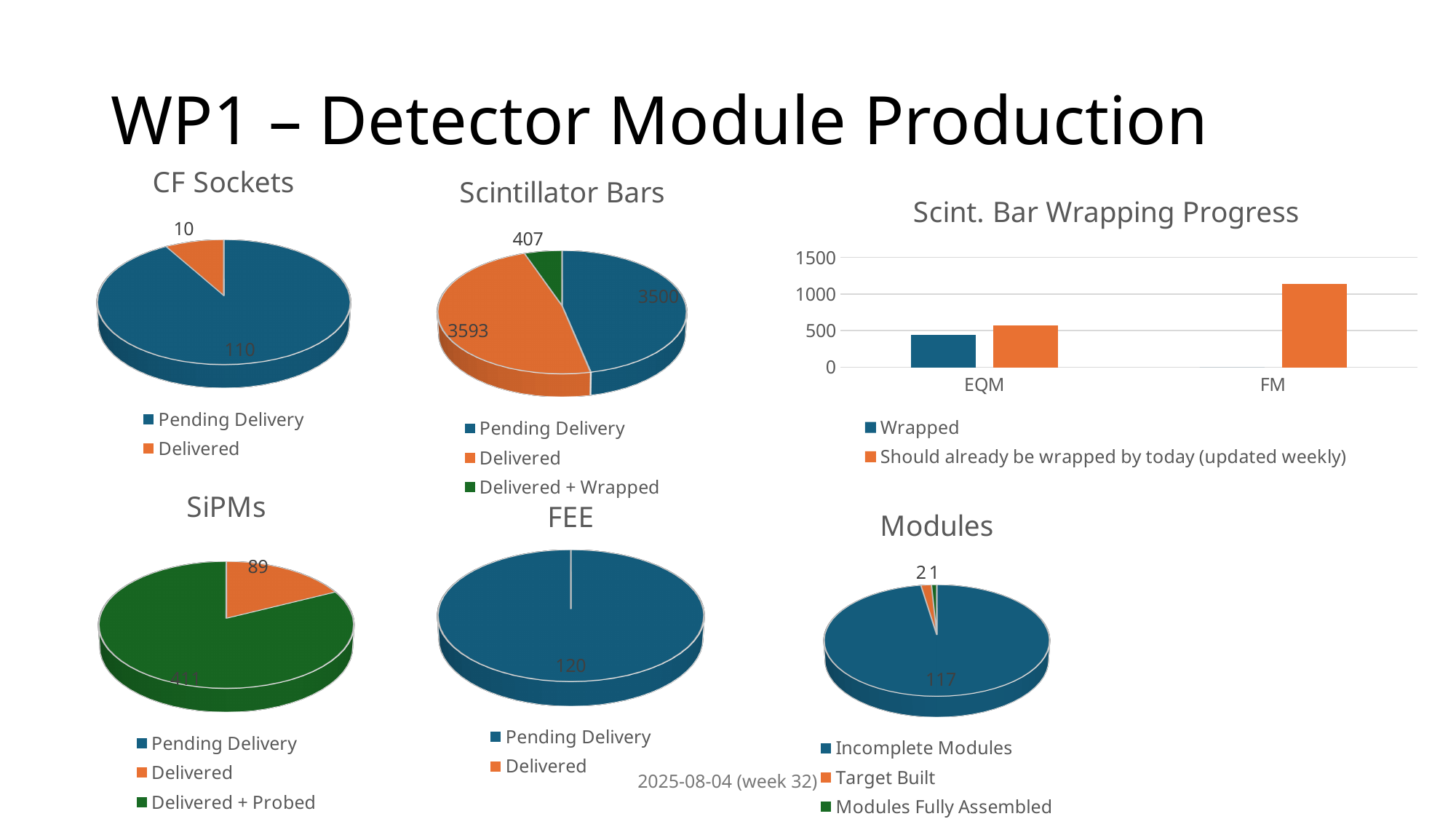
In the Scint. Bar Wrapping Progress chart, is the value for 'Should already be wrapped by today' for FM greater or less than 1000? greater In the CF Sockets pie chart, what is the value for Delivered? 10 In the SiPMs pie chart, what is the value for Delivered + Probed? 411 What kind of chart is the Scint. Bar Wrapping Progress chart? bar chart In the FEE pie chart, what is the value for Pending Delivery? 120 In the CF Sockets pie chart, what is the value for Pending Delivery? 110 In the Modules pie chart, what is the value for Incomplete Modules? 117 In the Scintillator Bars pie chart, what is the difference between Delivered and Pending Delivery? 93 In the Scintillator Bars pie chart, which category has the largest value? Delivered In the Scintillator Bars pie chart, what is the value for Delivered + Wrapped? 407 How many series does the legend of the Scint. Bar Wrapping Progress chart list? 2 In the Scint. Bar Wrapping Progress chart, is the Wrapped value for EQM greater or less than 500? less